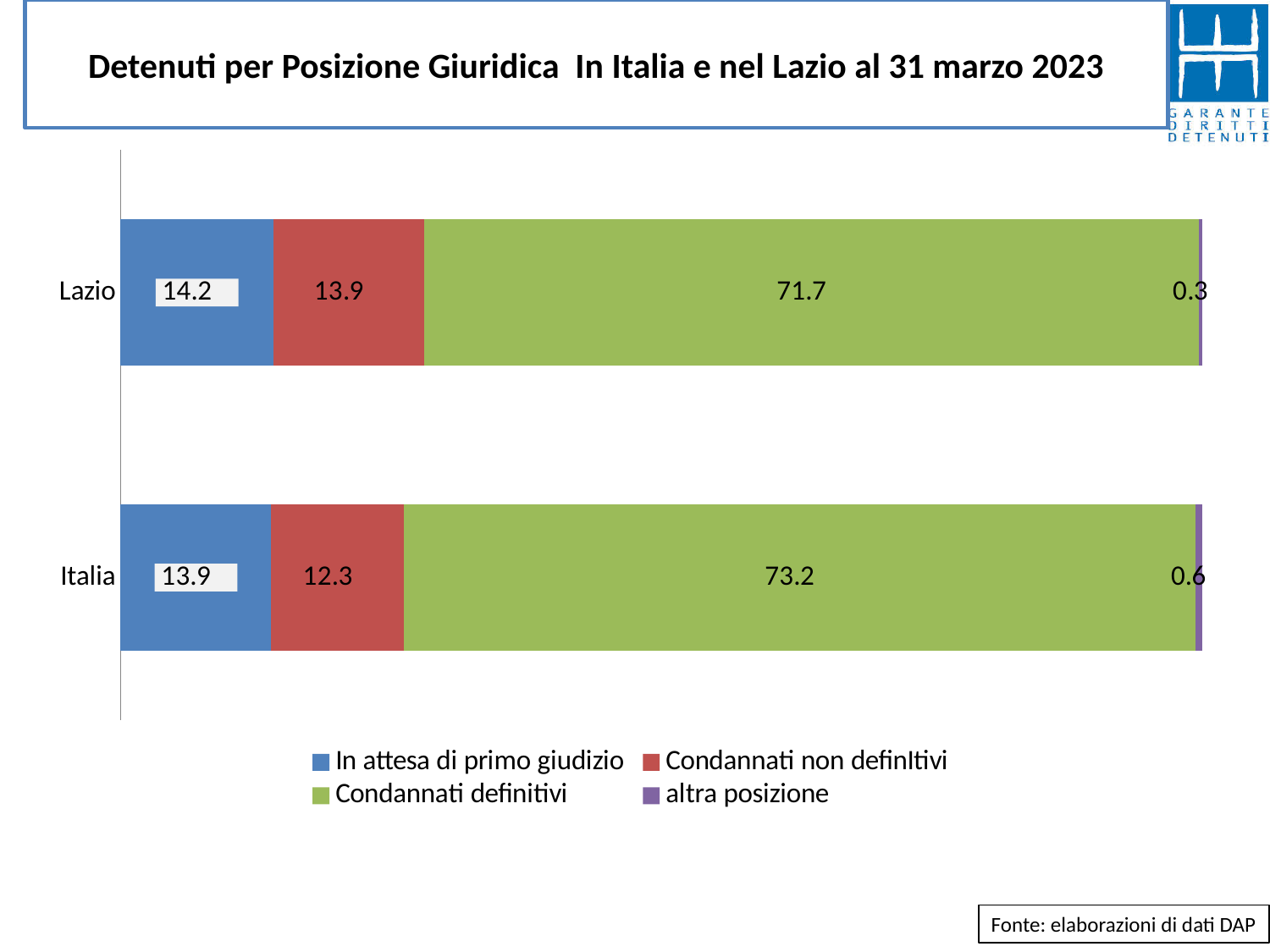
What is the difference between the 'Condannati definitivi' values for Italia and Lazio? 1.5 What is the title of the chart? Detenuti per Posizione Giuridica In Italia e nel Lazio al 31 marzo 2023 What kind of chart is shown on the slide? Stacked bar chart What is the difference between the 'Condannati non definitivi' values for Lazio and Italia? 1.6 Which category has the higher value for 'Condannati definitivi', Lazio or Italia? Italia Which series has the largest value in the Lazio bar? Condannati definitivi What is the value for 'altra posizione' for Italia? 0.6 What is the value for 'In attesa di primo giudizio' for Lazio? 14.2 What is the value for 'Condannati definitivi' for Italia? 73.2 How many categories (bars) are shown in the chart? 2 How many series does the legend list? 4 What is the value for 'Condannati non definitivi' for Lazio? 13.9